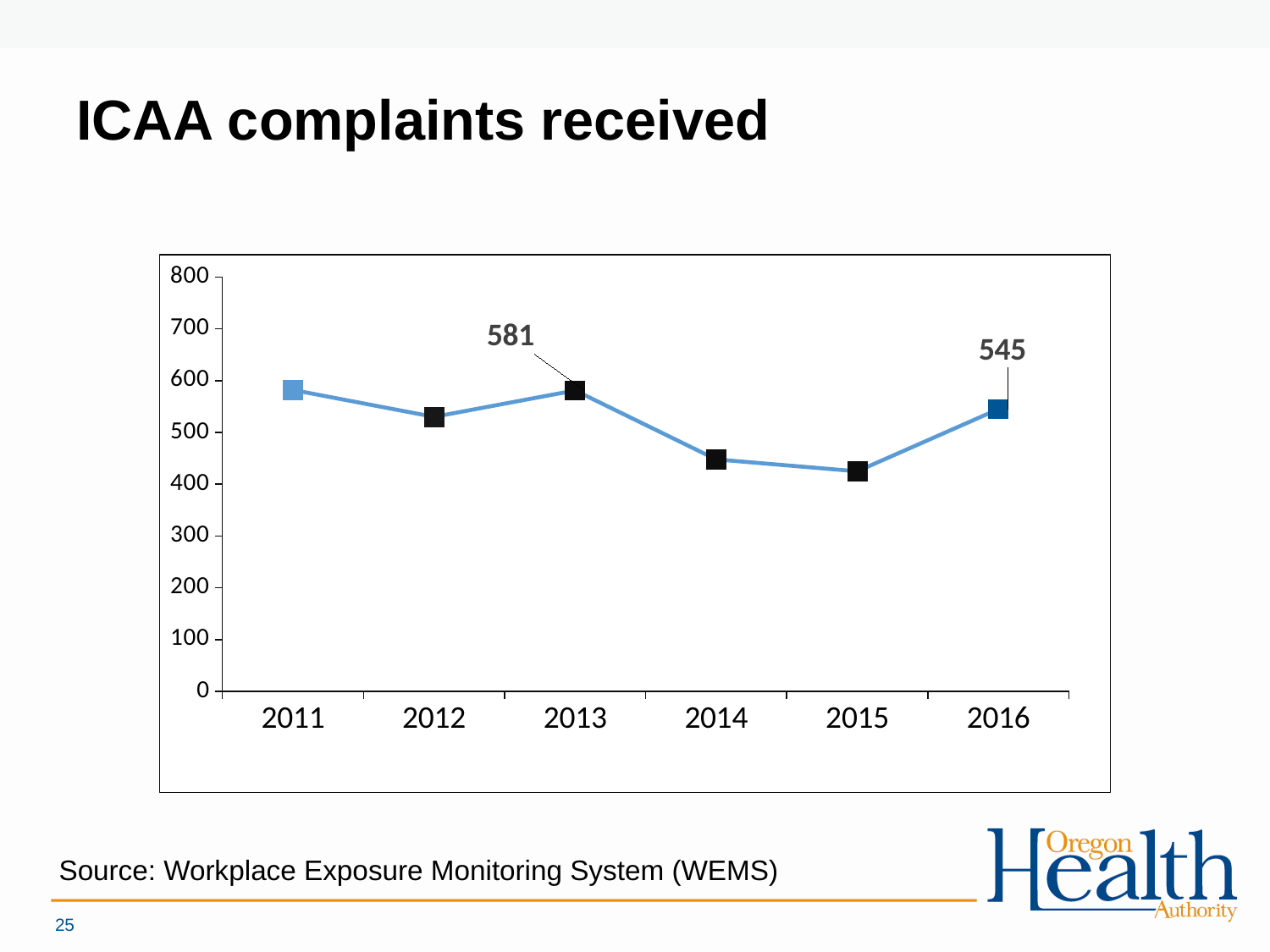
Which year has the larger value, 2013 or 2016? 2013 Which year has the lowest number of ICAA complaints received? 2015 Do the values rise or fall from 2013 to 2015? fall How many years are plotted on the chart? 6 Is the value for 2012 greater or less than 500? greater Is the value for 2014 greater or less than 500? less Is the value for 2015 greater or less than 500? less What value is labeled for 2013? 581 What value is labeled for 2016? 545 What is the title of the slide? ICAA complaints received What is the difference between the labeled values for 2013 and 2016? 36 What kind of chart is shown on the slide? line chart